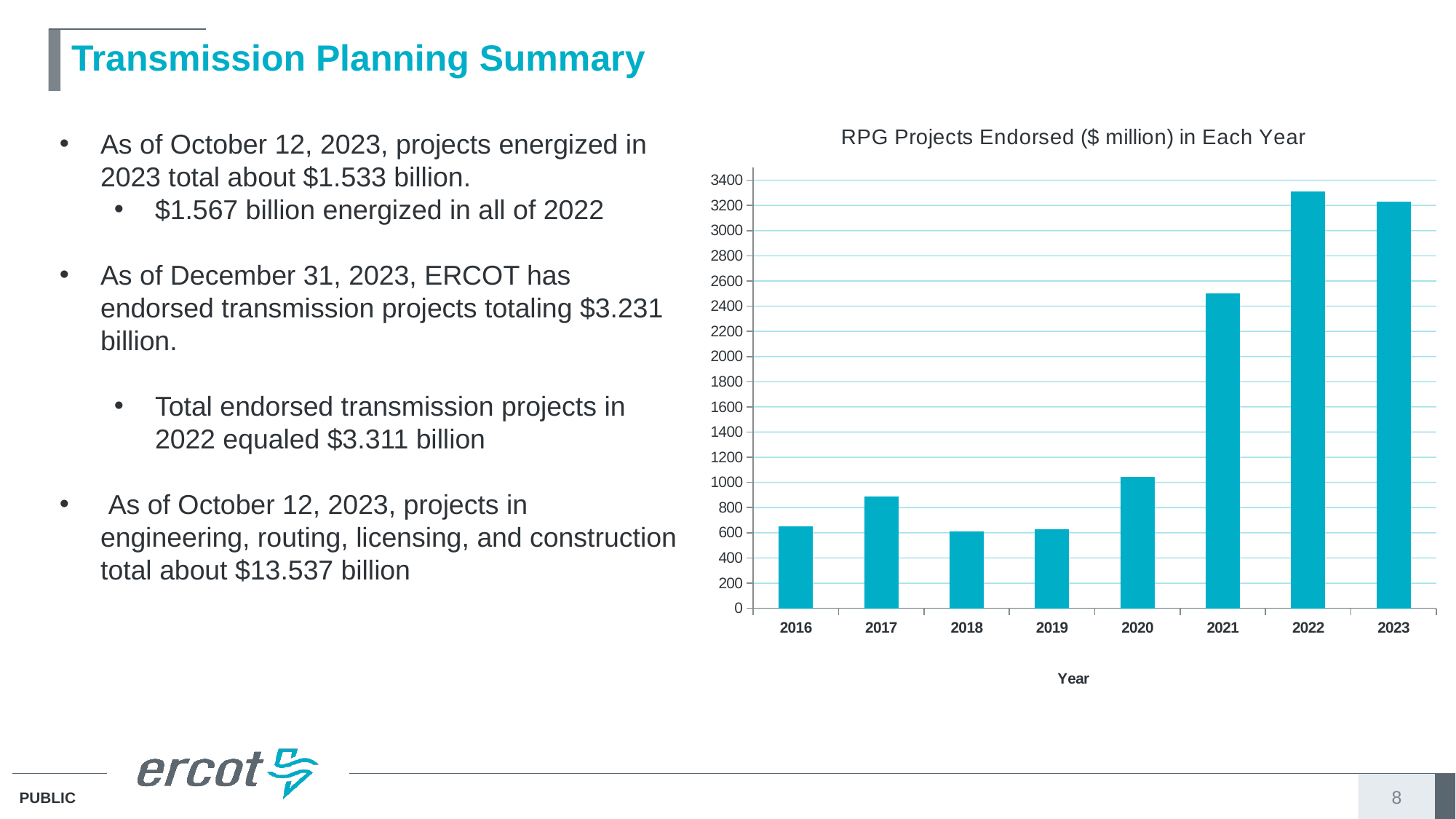
How many years are shown on the x axis of the chart? 8 What is the label of the x axis of the chart? Year Is the value for 2023 greater or less than 3000? greater Is the value for 2021 greater or less than 2400? greater What is the title of the chart? RPG Projects Endorsed ($ million) in Each Year Which is larger, the value for 2017 or the value for 2016? 2017 Which year has the highest value in the chart? 2022 What kind of chart is shown on the slide? bar chart Is the value for 2017 greater or less than 800? greater Which is larger, the value for 2021 or the value for 2020? 2021